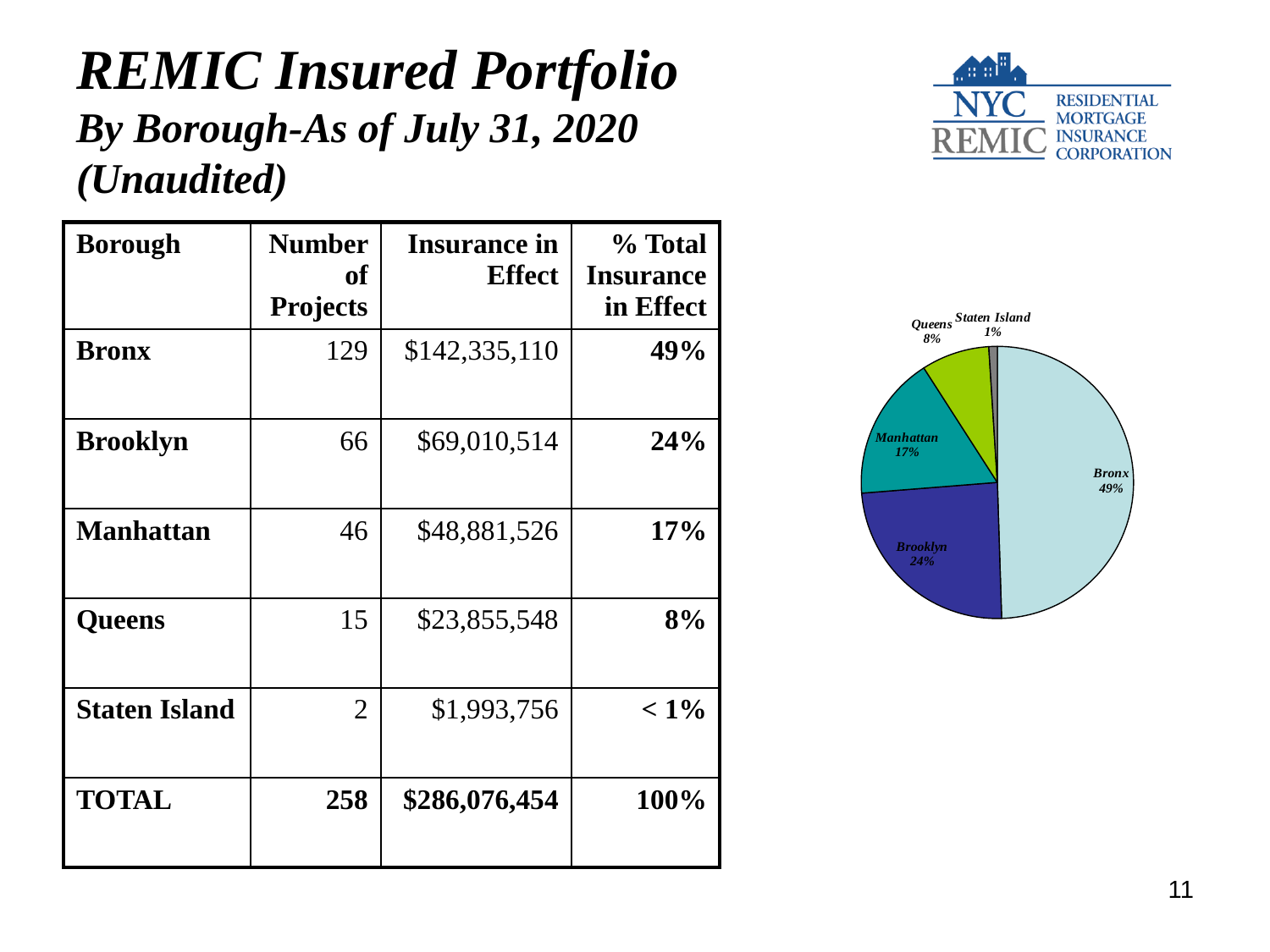
Which borough has the smallest slice in the pie chart? Staten Island What share of the pie chart does Manhattan represent? 17% Which borough has the largest slice in the pie chart? Bronx How many slices does the pie chart have? 5 What is the difference in percentage points between the Manhattan and Queens slices in the pie chart? 9 What share of the pie chart does Bronx represent? 49% What share of the pie chart does Staten Island represent? 1% What kind of chart is shown on the slide? pie chart What is the difference in percentage points between the Bronx and Brooklyn slices in the pie chart? 25 Which slice is larger in the pie chart, Brooklyn or Manhattan? Brooklyn